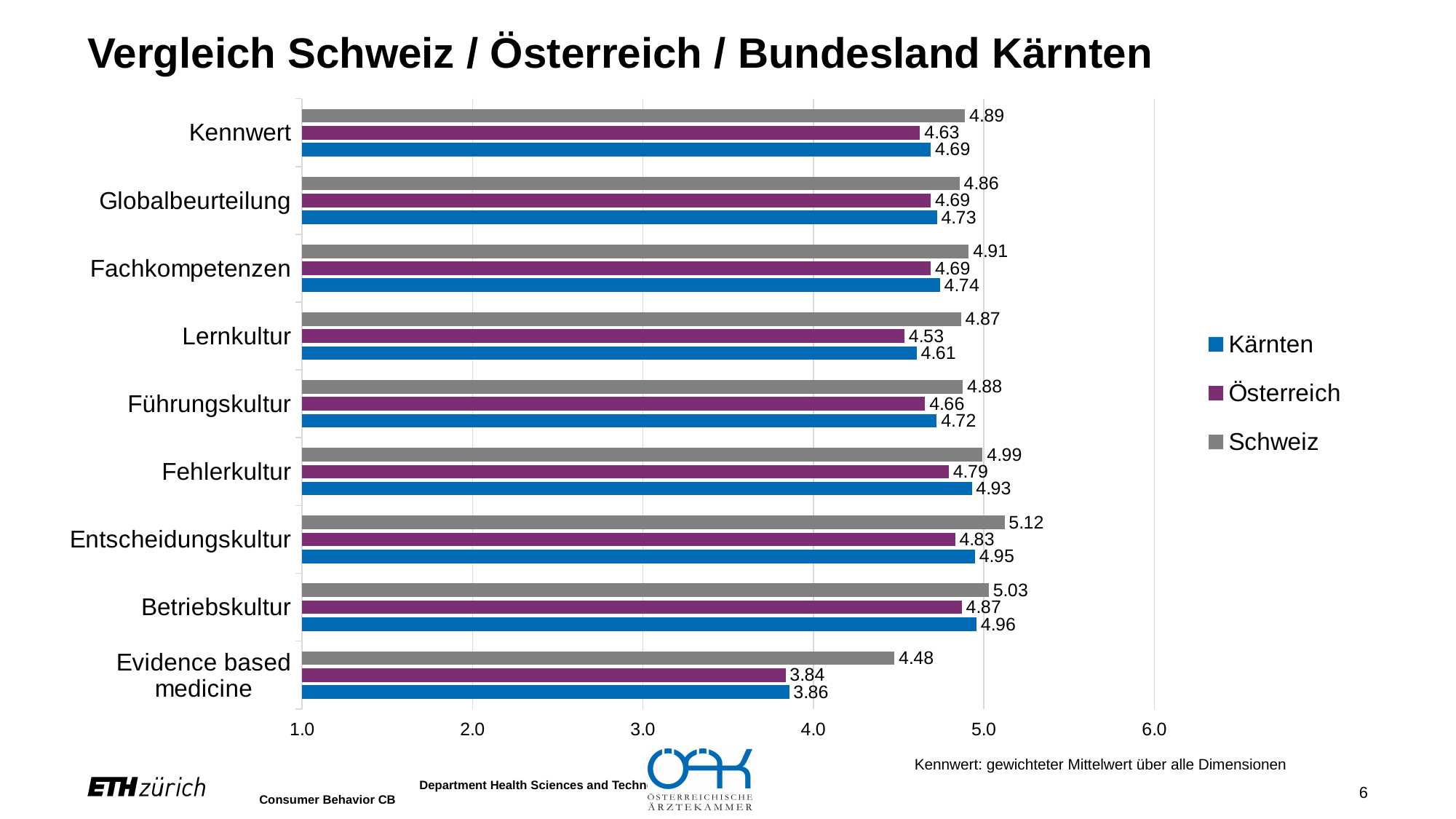
What is the Österreich value for Lernkultur? 4.53 What is the difference between the Schweiz and Kärnten values for Evidence based medicine? 0.62 How many series does the legend list? 3 What is the Schweiz value for Entscheidungskultur? 5.12 What is the Kärnten value for Evidence based medicine? 3.86 Which category has the highest Schweiz value? Entscheidungskultur Which is larger for Fehlerkultur: the Kärnten value or the Österreich value? Kärnten What kind of chart is shown on the slide? bar chart How many categories are shown on the y axis? 9 Which category has the lowest Österreich value? Evidence based medicine Is the Schweiz value for Betriebskultur greater or less than 5.0? greater Which series is shown in grey? Schweiz